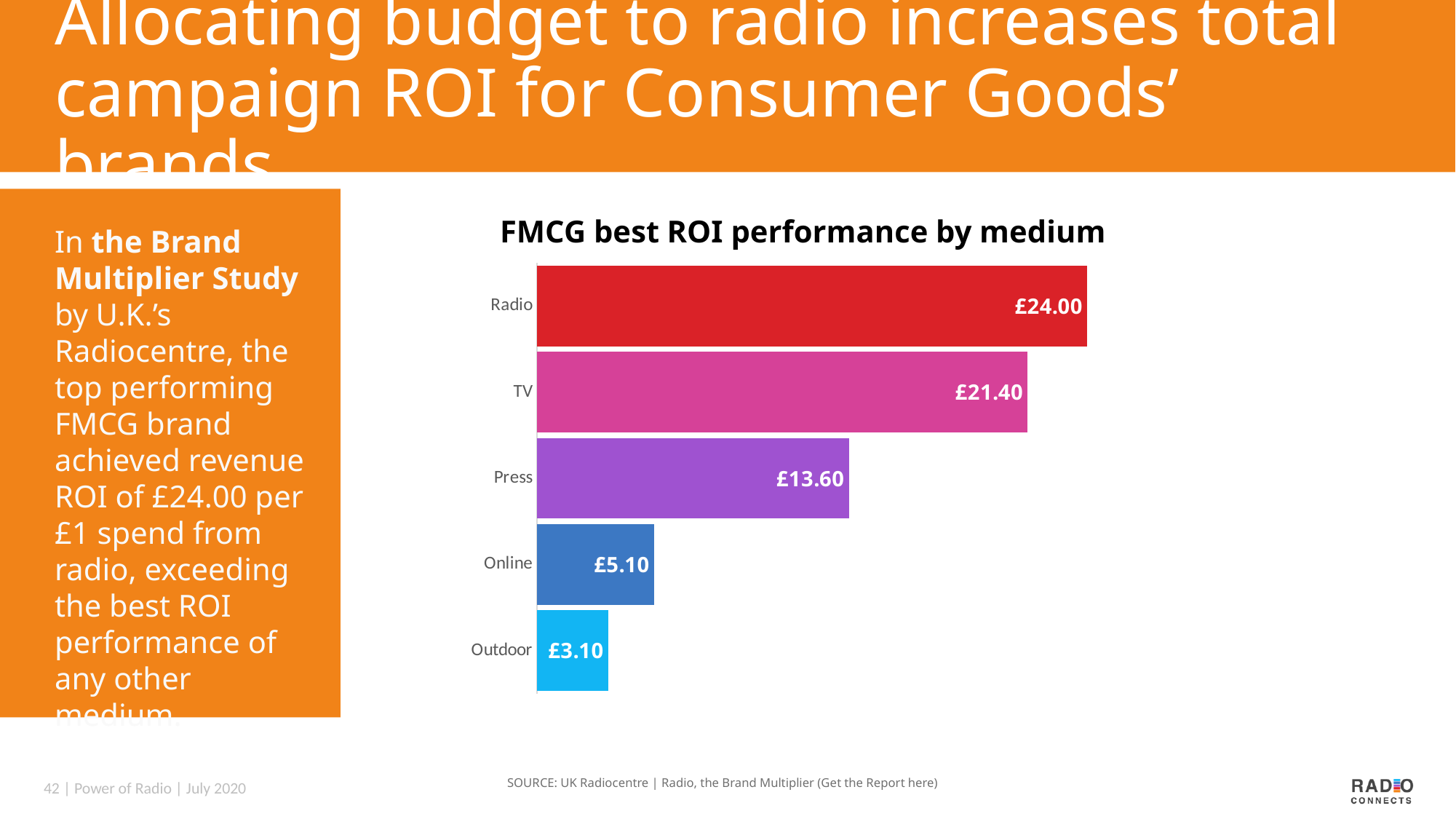
What is the difference between the ROI for Radio and the ROI for TV? £2.60 What kind of chart is shown on the slide? Bar chart What is the ROI value for Outdoor? £3.10 What is the ROI value for Radio? £24.00 Which medium has the highest ROI? Radio What is the difference between the ROI for Press and the ROI for Online? £8.50 What is the ROI value for TV? £21.40 What is the title of the chart? FMCG best ROI performance by medium Which has a larger ROI, Online or Outdoor? Online What is the ROI value for Press? £13.60 Which medium has the lowest ROI? Outdoor How many media are shown in the chart? 5